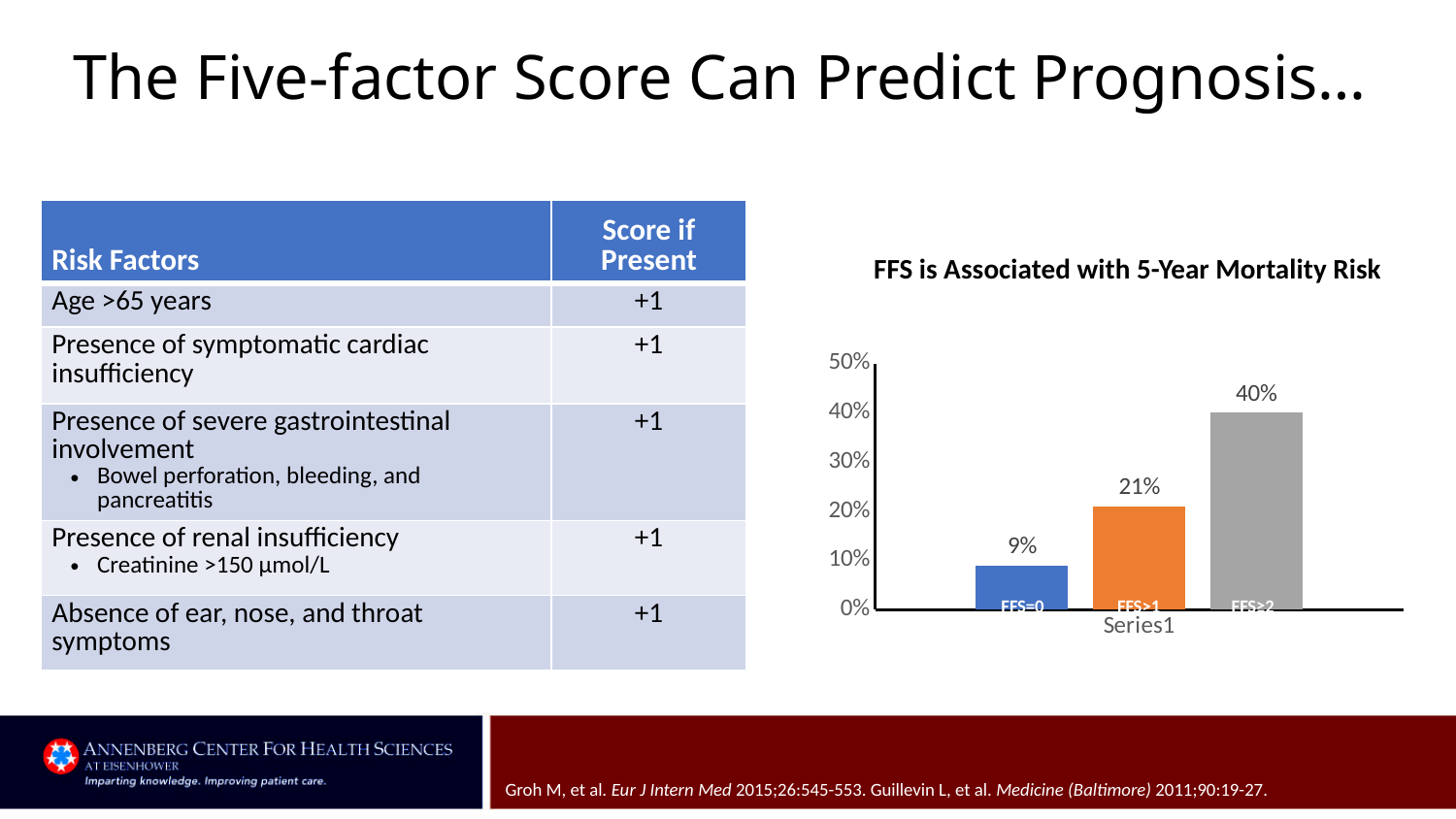
What is the difference between the value for FFS≥2 and the value for FFS=0? 31% How many bars are plotted in the chart? 3 What type of chart is shown on the slide? bar chart What is the 5-year mortality risk value shown for FFS≥2? 40% What is the 5-year mortality risk value shown for FFS=0? 9% Which is larger, the value for FFS=0 or the value for FFS≥2? FFS≥2 Which category has the highest value in the chart? FFS≥2 What is the value shown for the middle (orange) bar in the chart? 21% What is the title of the chart on the slide? FFS is Associated with 5-Year Mortality Risk Which category has the lowest value in the chart? FFS=0 Do the values rise or fall from left to right across the bars? rise What is the difference between the value for FFS≥2 and the value of the middle (orange) bar? 19%